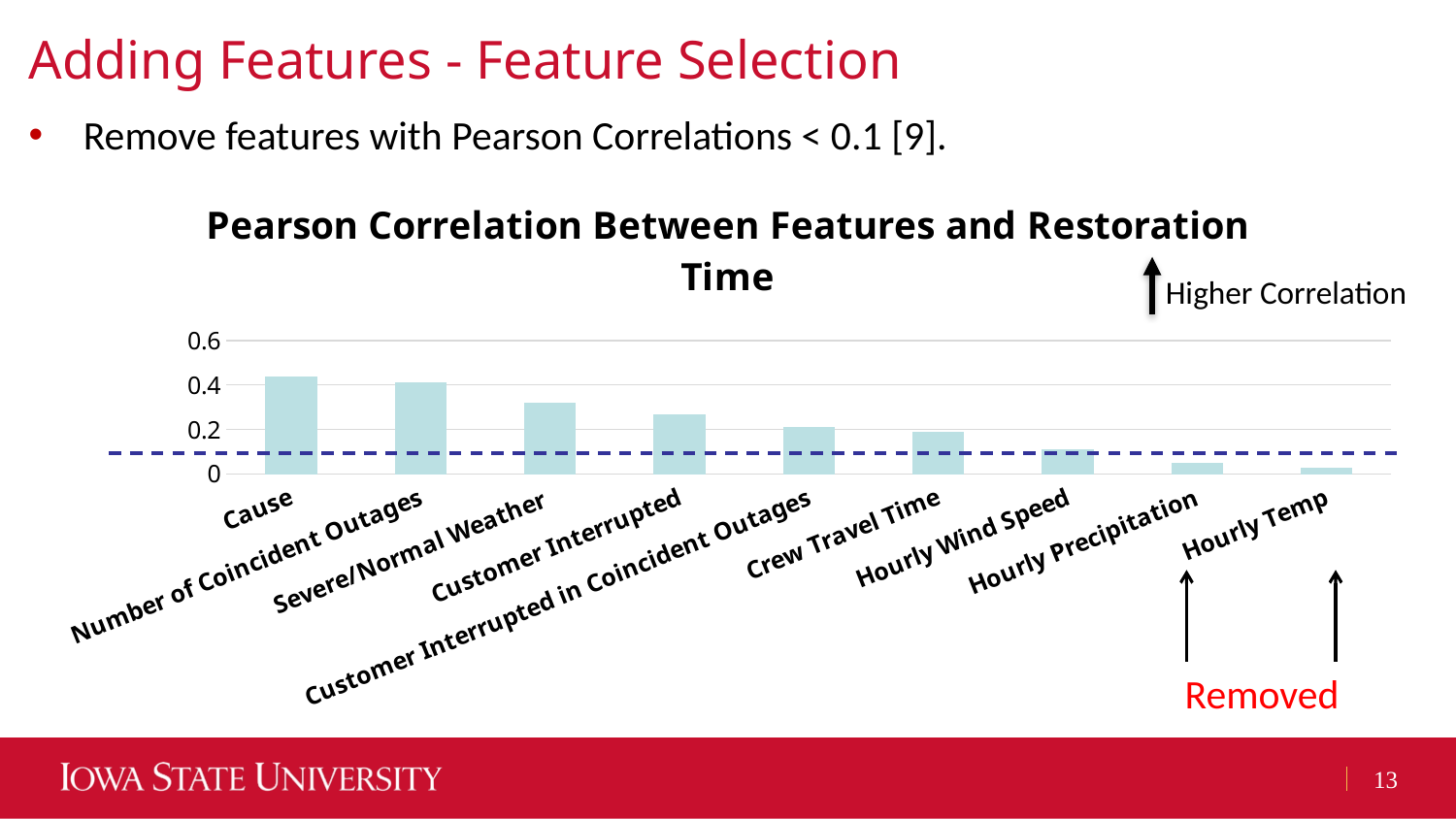
Which feature has the lowest Pearson correlation in the chart? Hourly Temp Do the bar values rise or fall moving from left to right along the x axis? fall How many features (categories) are plotted in the chart? 9 Is the value for Severe/Normal Weather greater or less than 0.2? greater Is the value for Hourly Wind Speed greater or less than 0.2? less What is the title of the chart? Pearson Correlation Between Features and Restoration Time Is the value for Customer Interrupted greater or less than 0.4? less Which has the larger value, Severe/Normal Weather or Crew Travel Time? Severe/Normal Weather Which two features are marked as "Removed" on the slide? Hourly Precipitation and Hourly Temp What kind of chart is shown on the slide? bar chart Which has the larger value, Hourly Wind Speed or Customer Interrupted? Customer Interrupted